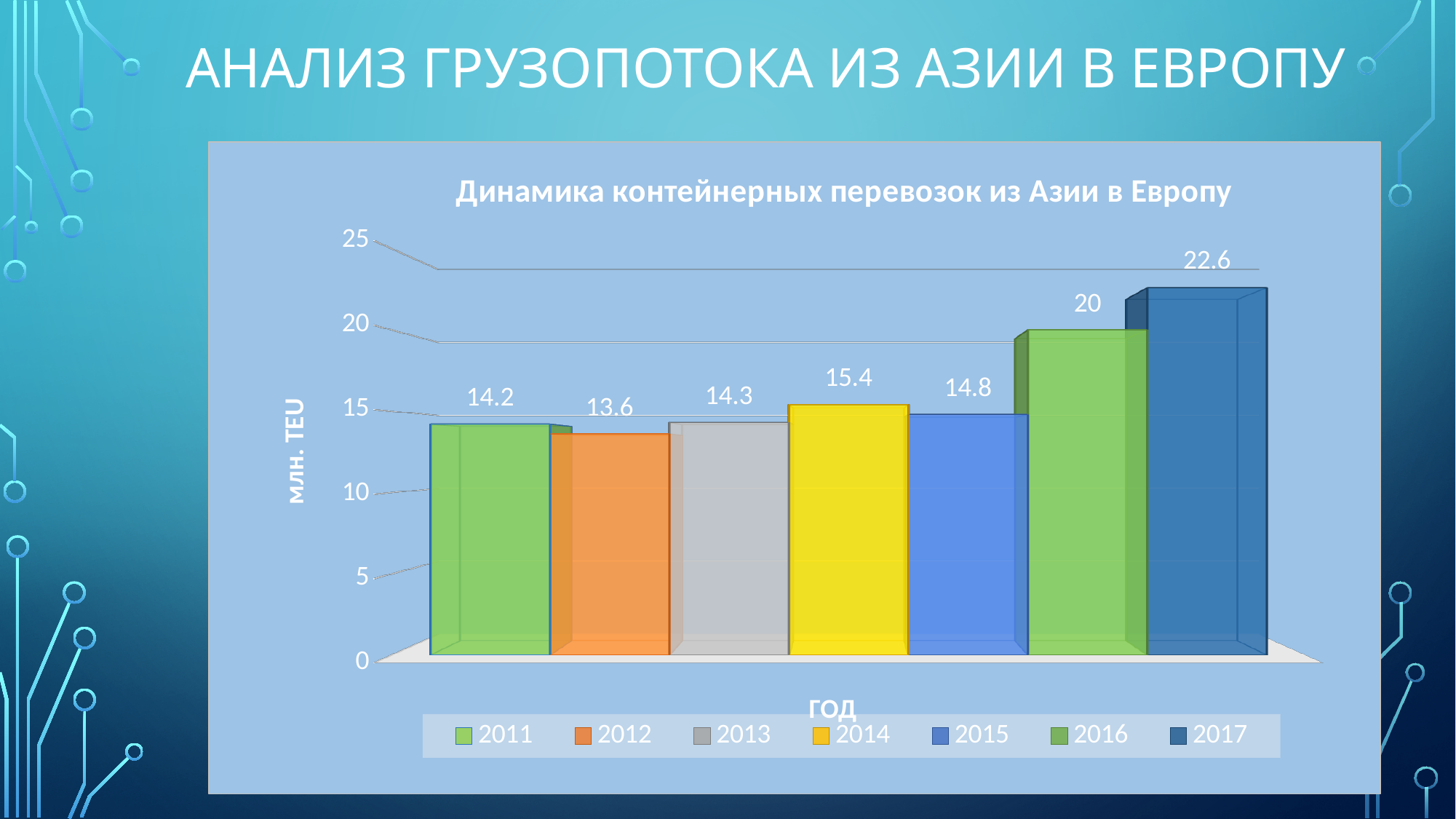
Is the value for 2016 greater or less than 15? greater How many years are shown in the chart? 7 What is the title of the chart? Динамика контейнерных перевозок из Азии в Европу What is the difference between the values for 2014 and 2015? 0.6 What kind of chart is shown on the slide? bar chart What is the value for 2011? 14.2 Which year has the highest value? 2017 Which is larger, the value for 2013 or the value for 2012? 2013 What is the value for 2017? 22.6 What is the difference between the values for 2017 and 2016? 2.6 Which year has the lowest value? 2012 What is the value for 2014? 15.4